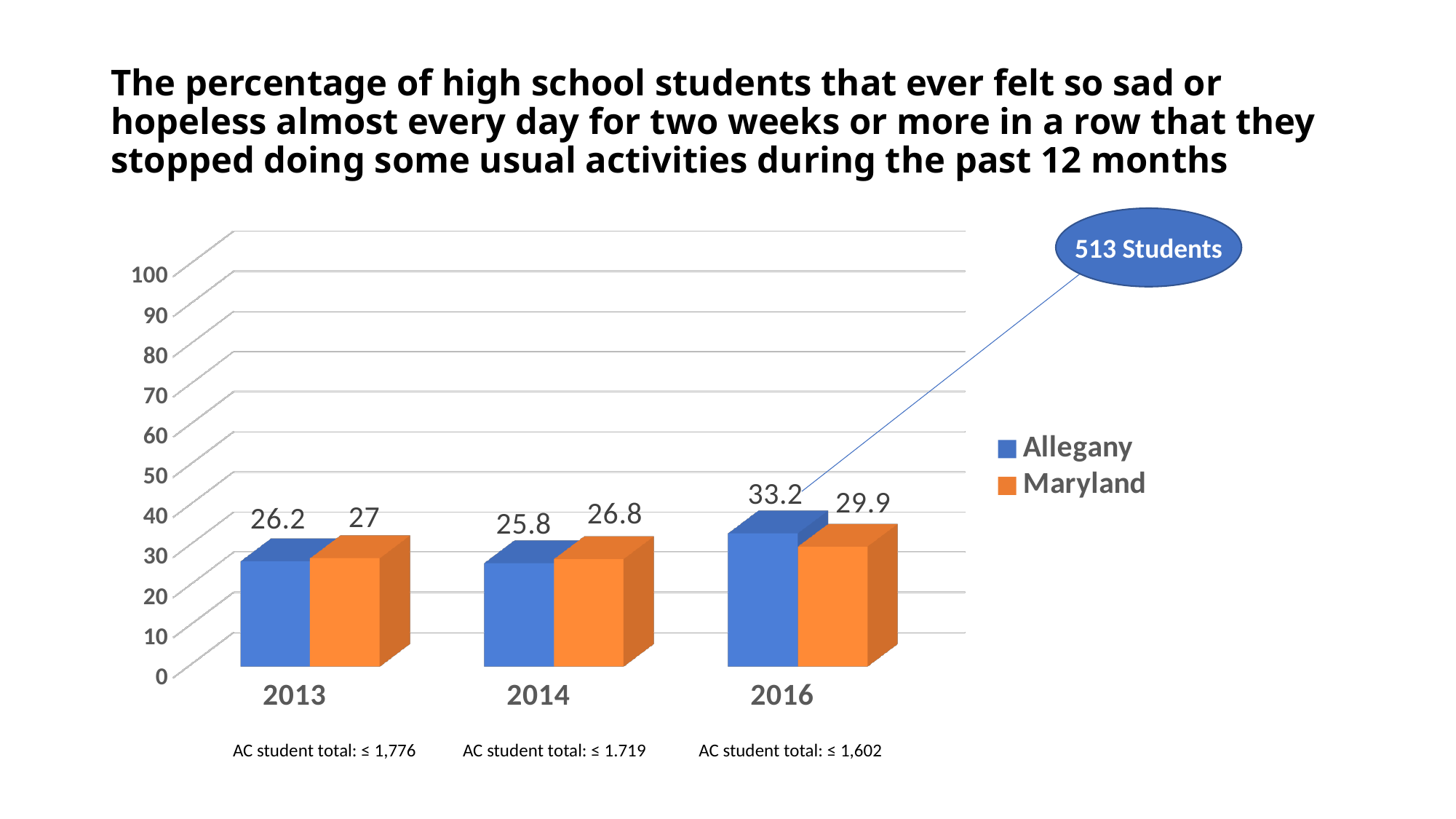
In which year is the Allegany value highest? 2016 What kind of chart is shown on the slide? bar chart How many series does the legend list? 2 What is the value for Allegany in 2016? 33.2 What is the value for Maryland in 2016? 29.9 Which is larger in 2014, the Allegany value or the Maryland value? Maryland How many years are shown on the x axis? 3 In which year is the Allegany value lowest? 2014 Is the value for Allegany in 2016 greater or less than 30? greater What is the value for Maryland in 2013? 27 What is the difference between the Allegany and Maryland values in 2016? 3.3 What is the value for Allegany in 2014? 25.8